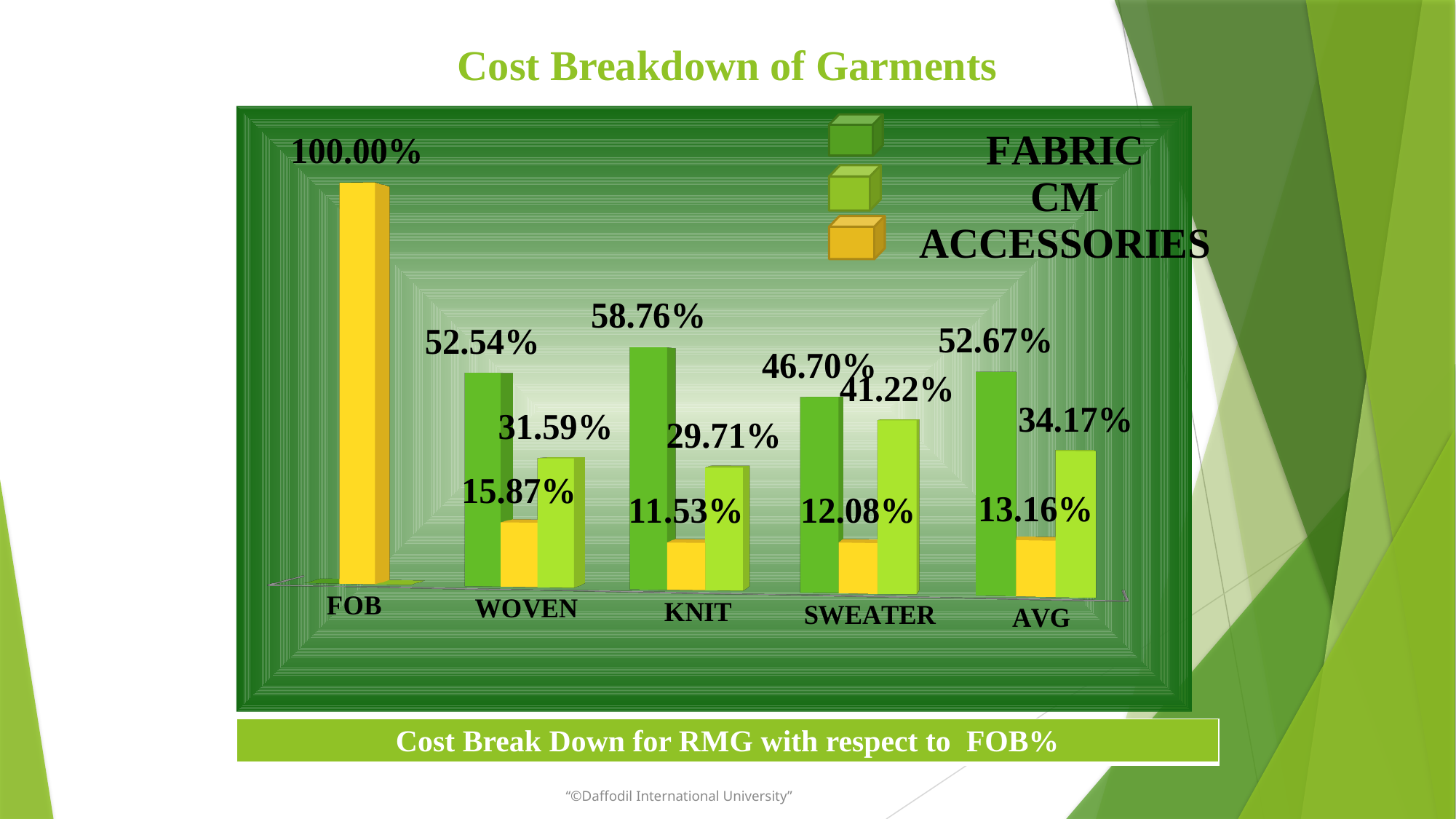
What kind of chart is shown on the slide? Bar chart Which garment type (WOVEN, KNIT, SWEATER or AVG) has the lowest ACCESSORIES value? KNIT What is the CM value for SWEATER? 41.22% Which is larger, the CM value for WOVEN or the CM value for AVG? AVG What is the difference between the FABRIC value for KNIT and the FABRIC value for SWEATER? 12.06% What is the ACCESSORIES value for WOVEN? 15.87% How many categories are shown on the x axis? 5 How many series does the legend list? 3 Which garment type (WOVEN, KNIT, SWEATER or AVG) has the highest FABRIC value? KNIT What is the FABRIC value for KNIT? 58.76% What is the value shown for FOB? 100.00%